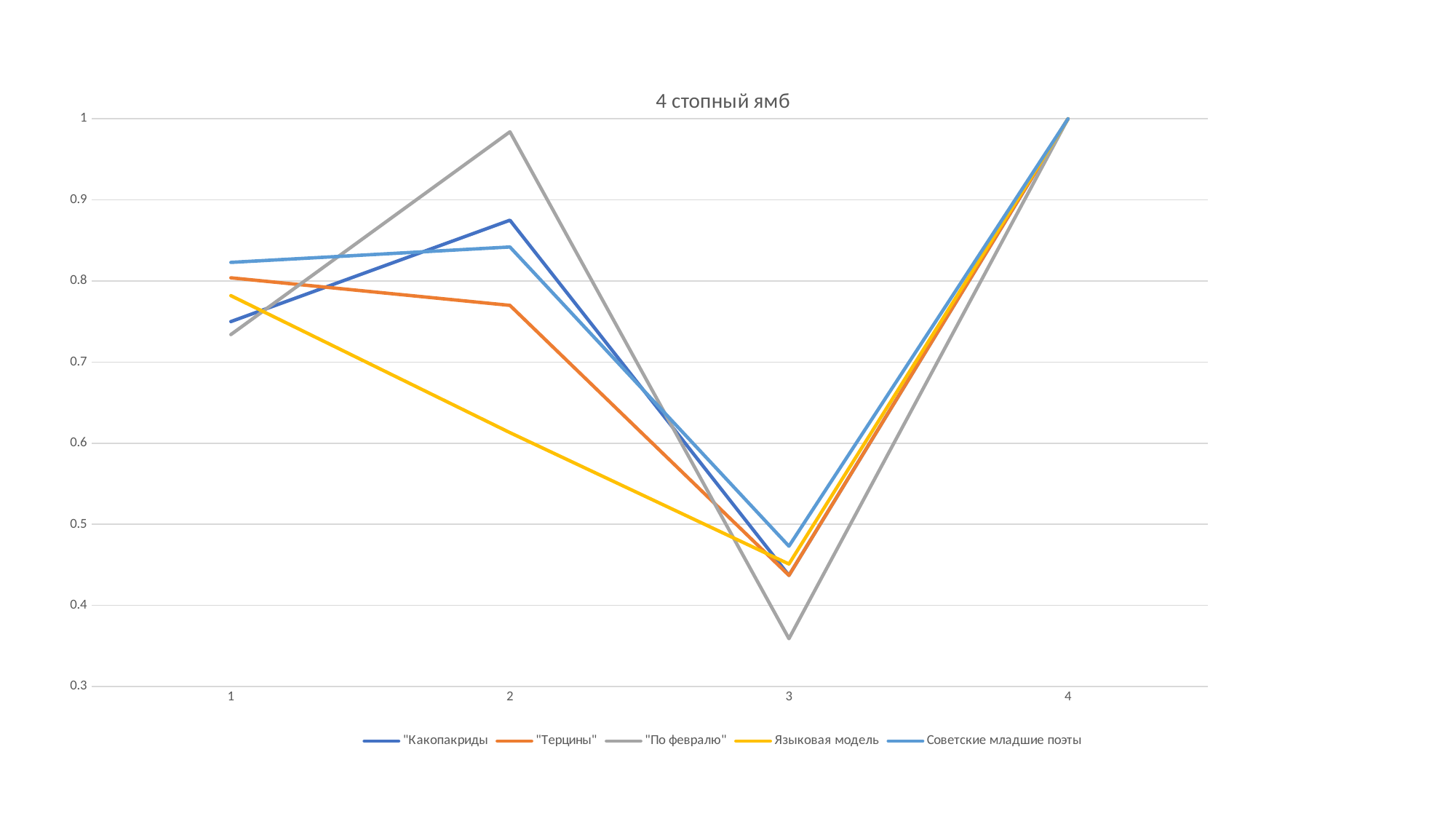
At point 2, which is larger: "Терцины" or "Языковая модель"? "Терцины" Which series has the lowest value at point 3? "По февралю" Do the values of "Языковая модель" rise or fall from point 3 to point 4? rise What kind of chart is shown on the slide? line chart How many points are there along the x axis? 4 Is the value for "По февралю" at point 3 greater or less than 0.4? less Is the value for "Какопакриды" at point 2 greater or less than 0.8? greater What is the value of "Какопакриды" at point 4? 1 How many series does the legend list? 5 Which series has the highest value at point 2? "По февралю" What is the title of the chart? 4 стопный ямб Is the value for "По февралю" at point 2 greater or less than 0.9? greater